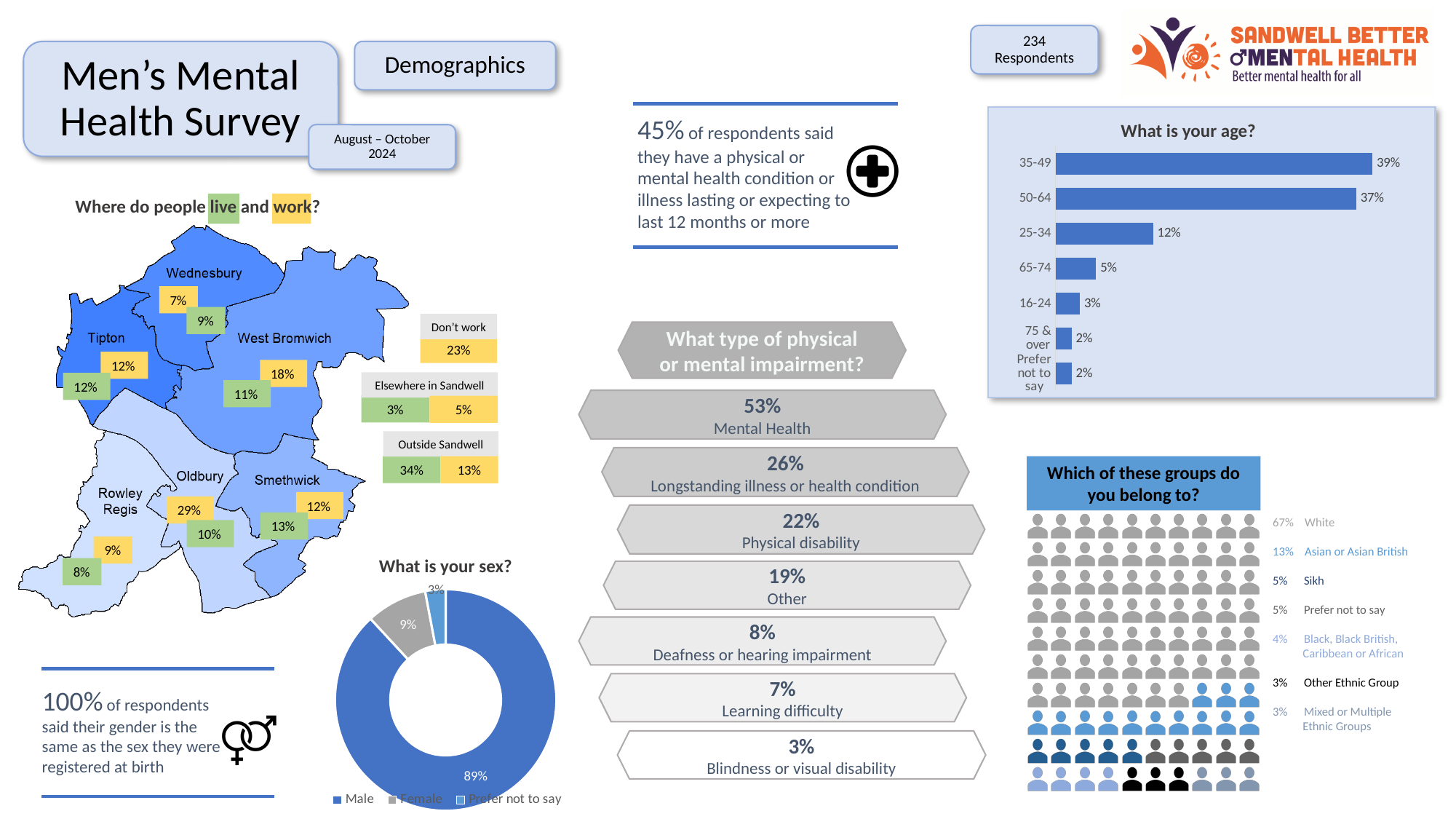
In the 'What is your age?' chart, what percentage of respondents are aged 35-49? 39% What kind of chart is 'What is your sex?' Donut chart In the 'What is your age?' chart, what is the difference in percentage points between the 35-49 and 50-64 groups? 2 In the 'What is your sex?' chart, what percentage of respondents are Male? 89% In the 'What is your age?' chart, which age group has the highest percentage? 35-49 What kind of chart is 'What is your age?' Bar chart How many age categories are shown in the 'What is your age?' chart? 7 In the 'What is your sex?' chart, what percentage of respondents are Female? 9% In the 'What is your age?' chart, what percentage of respondents are aged 25-34? 12% In the 'What is your sex?' chart, which category has the smallest share? Prefer not to say In the 'What is your age?' chart, which is larger, the value for 65-74 or the value for 16-24? 65-74 How many entries does the legend of the 'What is your sex?' chart list? 3